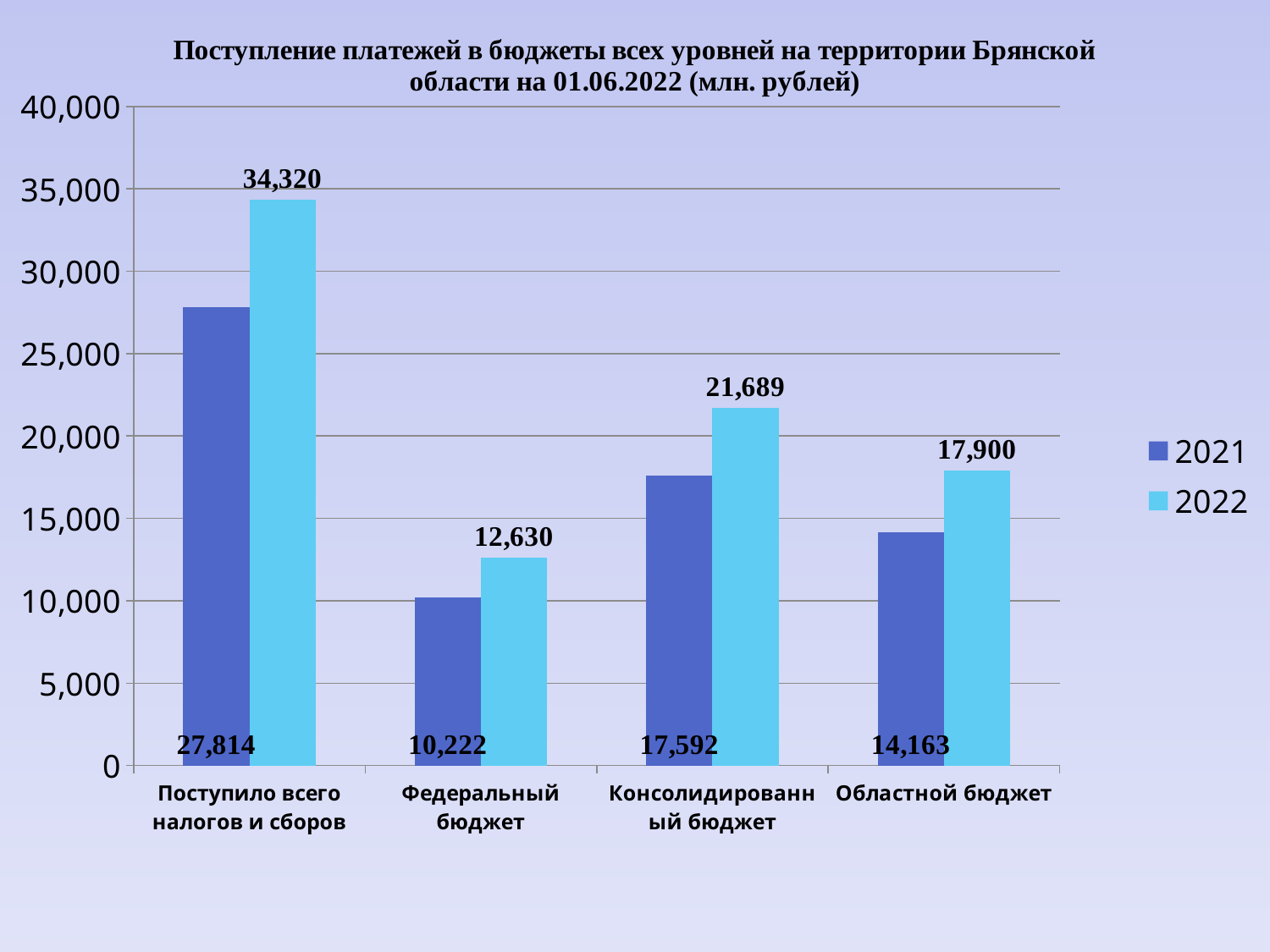
What is the difference between the 2022 and 2021 values for Поступило всего налогов и сборов? 6,506 What is the 2022 value for Поступило всего налогов и сборов? 34,320 What is the 2021 value for Федеральный бюджет? 10,222 What is the 2022 value for Консолидированный бюджет? 21,689 Which category has the highest 2021 value? Поступило всего налогов и сборов Which category has the lowest 2022 value? Федеральный бюджет What is the 2021 value for Областной бюджет? 14,163 What kind of chart is shown on the slide? Bar chart Which is larger: the 2021 value for Консолидированный бюджет or the 2022 value for Областной бюджет? 2022 value for Областной бюджет How many series does the legend list? 2 How many categories are shown on the x axis? 4 What is the difference between the 2022 and 2021 values for Областной бюджет? 3,737